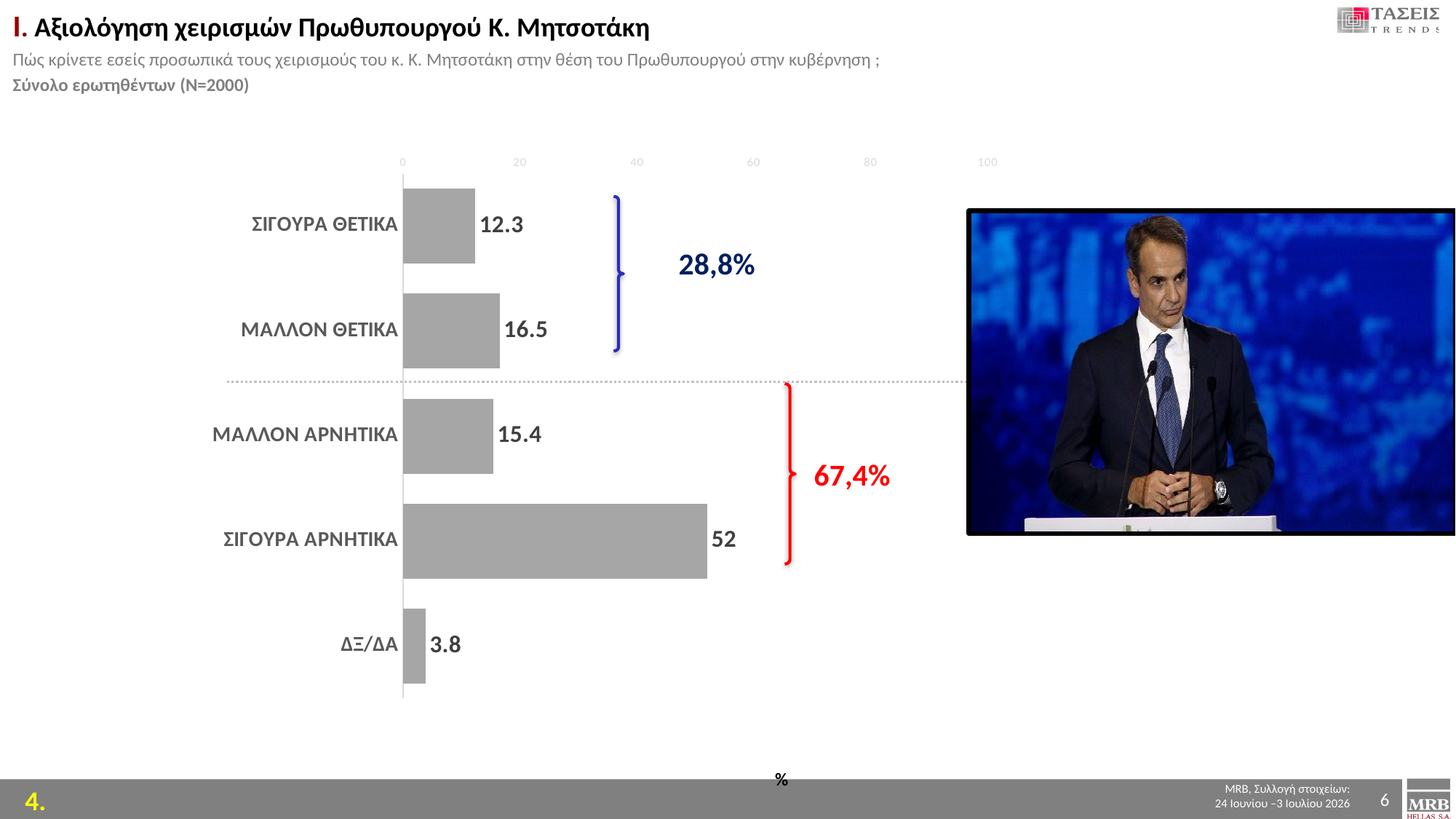
Which is larger, the value for ΜΑΛΛΟΝ ΘΕΤΙΚΑ or the value for ΣΙΓΟΥΡΑ ΘΕΤΙΚΑ? ΜΑΛΛΟΝ ΘΕΤΙΚΑ What combined percentage is shown by the red bracket next to the negative categories? 67,4% What is the value for ΔΞ/ΔΑ? 3.8 Is the value for ΣΙΓΟΥΡΑ ΑΡΝΗΤΙΚΑ greater or less than 40? greater Which category has the highest value? ΣΙΓΟΥΡΑ ΑΡΝΗΤΙΚΑ What kind of chart is shown on the slide? bar chart What is the value for ΜΑΛΛΟΝ ΘΕΤΙΚΑ? 16.5 Which category has the lowest value? ΔΞ/ΔΑ What is the value for ΣΙΓΟΥΡΑ ΑΡΝΗΤΙΚΑ? 52 How many categories are shown in the chart? 5 What is the difference between the values for ΣΙΓΟΥΡΑ ΑΡΝΗΤΙΚΑ and ΜΑΛΛΟΝ ΑΡΝΗΤΙΚΑ? 36.6 What is the value for ΣΙΓΟΥΡΑ ΘΕΤΙΚΑ? 12.3